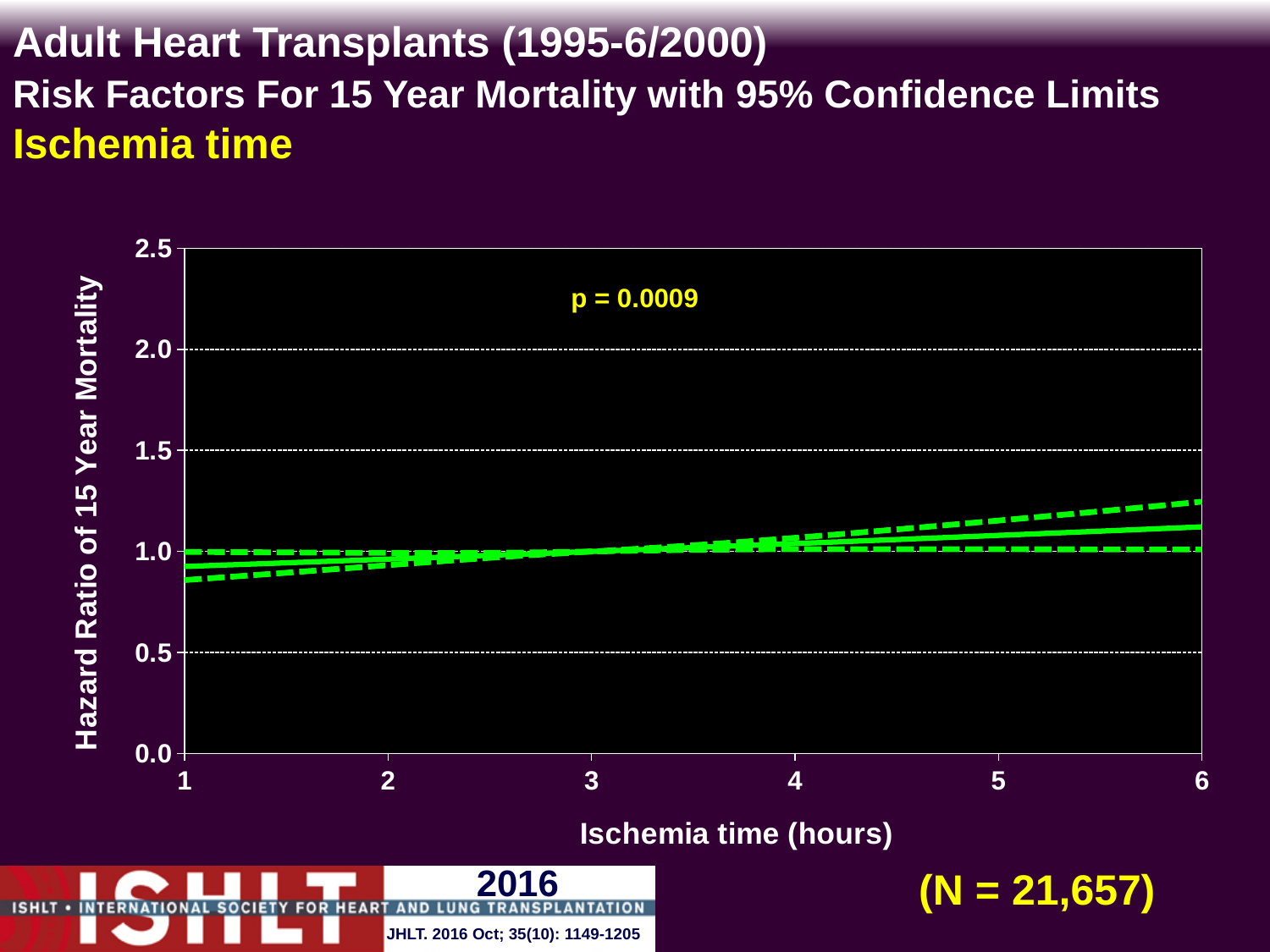
Is the lower 95% confidence limit at an ischemia time of 1 hour greater or less than 0.5? greater At which ischemia time shown on the x axis is the hazard ratio lowest? 1 hour Is the hazard ratio (solid line) at an ischemia time of 1 hour greater or less than 1.0? less What kind of chart is shown on the slide? line chart Does the hazard ratio of 15 year mortality rise or fall as ischemia time increases from 1 to 6 hours? rise Is the upper 95% confidence limit at an ischemia time of 6 hours greater or less than 1.5? less At which ischemia time shown on the x axis is the hazard ratio highest? 6 hours What is the sample size (N) shown on the slide? N = 21,657 What p-value is printed on the chart? p = 0.0009 Is the hazard ratio larger at an ischemia time of 5 hours or at 2 hours? 5 hours How many tick values are labelled on the x axis (ischemia time)? 6